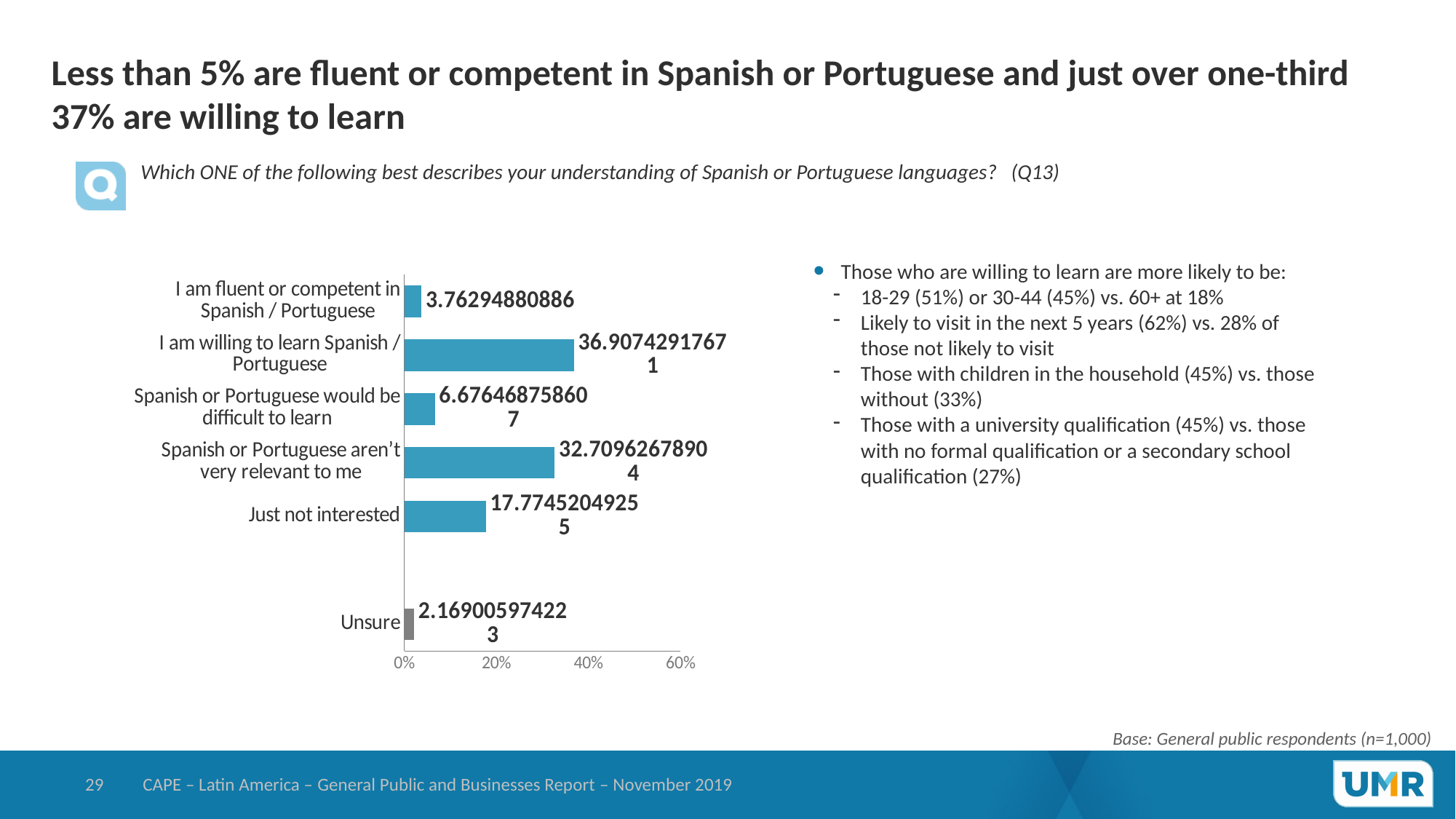
Which category has the highest value in the chart? I am willing to learn Spanish / Portuguese How many categories are plotted in the bar chart? 6 Is the value for 'Spanish or Portuguese would be difficult to learn' greater or less than 20%? less What is the data label for 'I am willing to learn Spanish / Portuguese'? 36.90742917671 What is the data label for 'Just not interested'? 17.77452049255 What is the highest tick value shown on the x axis of the chart? 60% What is the data label for 'I am fluent or competent in Spanish / Portuguese'? 3.76294880886 What is the data label for 'Unsure'? 2.169005974223 Which is larger: 'Spanish or Portuguese aren't very relevant to me' or 'Just not interested'? Spanish or Portuguese aren't very relevant to me Is the value for 'I am willing to learn Spanish / Portuguese' greater or less than 40%? less Which category has the lowest value in the chart? Unsure What type of chart is shown on the slide? bar chart